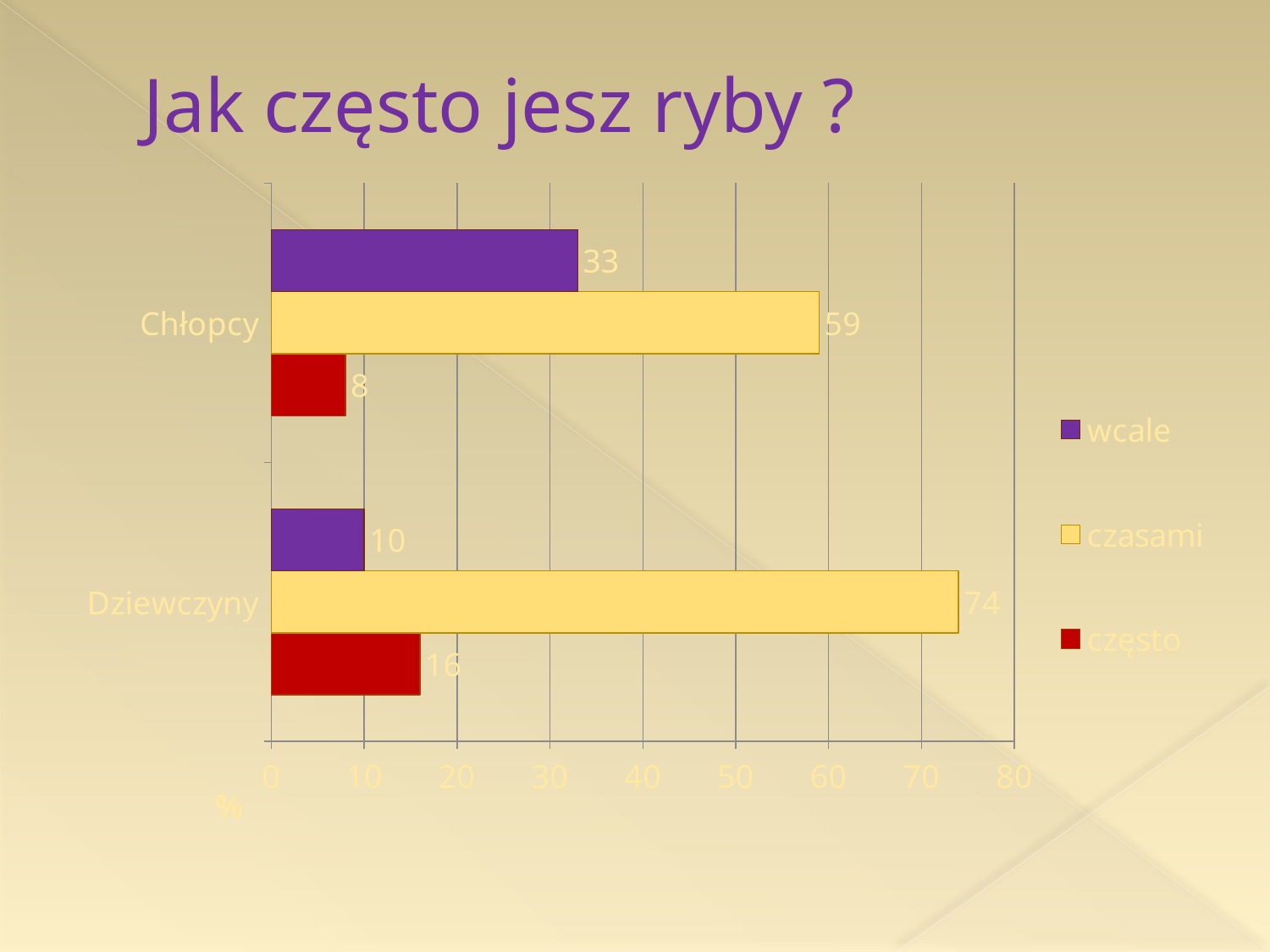
What is the value for 'czasami' in the Chłopcy category? 59 Which is larger: the 'wcale' value for Chłopcy or for Dziewczyny? Chłopcy What is the value for 'często' in the Dziewczyny category? 16 How many categories are shown on the chart? 2 What is the value for 'wcale' in the Chłopcy category? 33 Which series has the lowest value in the Chłopcy category? często Is the 'często' value for Chłopcy greater or less than 10? less How many series does the legend list? 3 What kind of chart is shown on the slide? bar chart What is the value for 'wcale' in the Dziewczyny category? 10 What is the difference between the 'czasami' values for Dziewczyny and Chłopcy? 15 Which series has the highest value in the Dziewczyny category? czasami